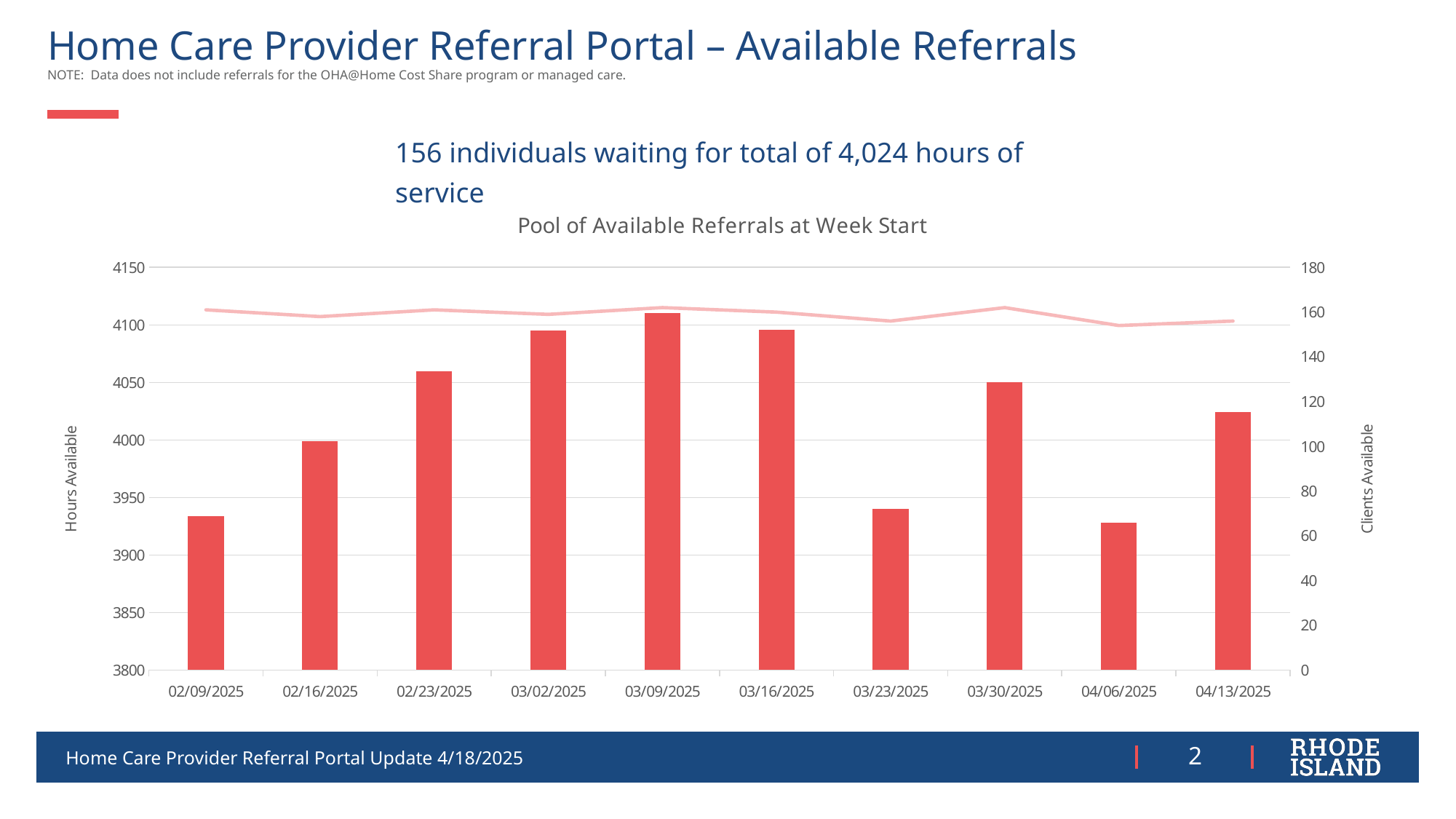
Which week start has the tallest bar for Hours Available? 03/09/2025 Which has the larger Hours Available bar, 02/16/2025 or 02/23/2025? 02/23/2025 Is the Hours Available bar for 02/09/2025 greater or less than 3950? less How many week-start dates are shown on the x axis of the chart? 10 Which has the larger Hours Available bar, 03/02/2025 or 03/23/2025? 03/02/2025 Is the Clients Available line value for 03/09/2025 greater or less than 140? greater Is the Hours Available bar for 04/06/2025 greater or less than 3950? less What kind of chart is shown on the slide? A bar chart with a line overlay What is the label of the right-hand vertical axis of the chart? Clients Available What is the title of the chart on the slide? Pool of Available Referrals at Week Start